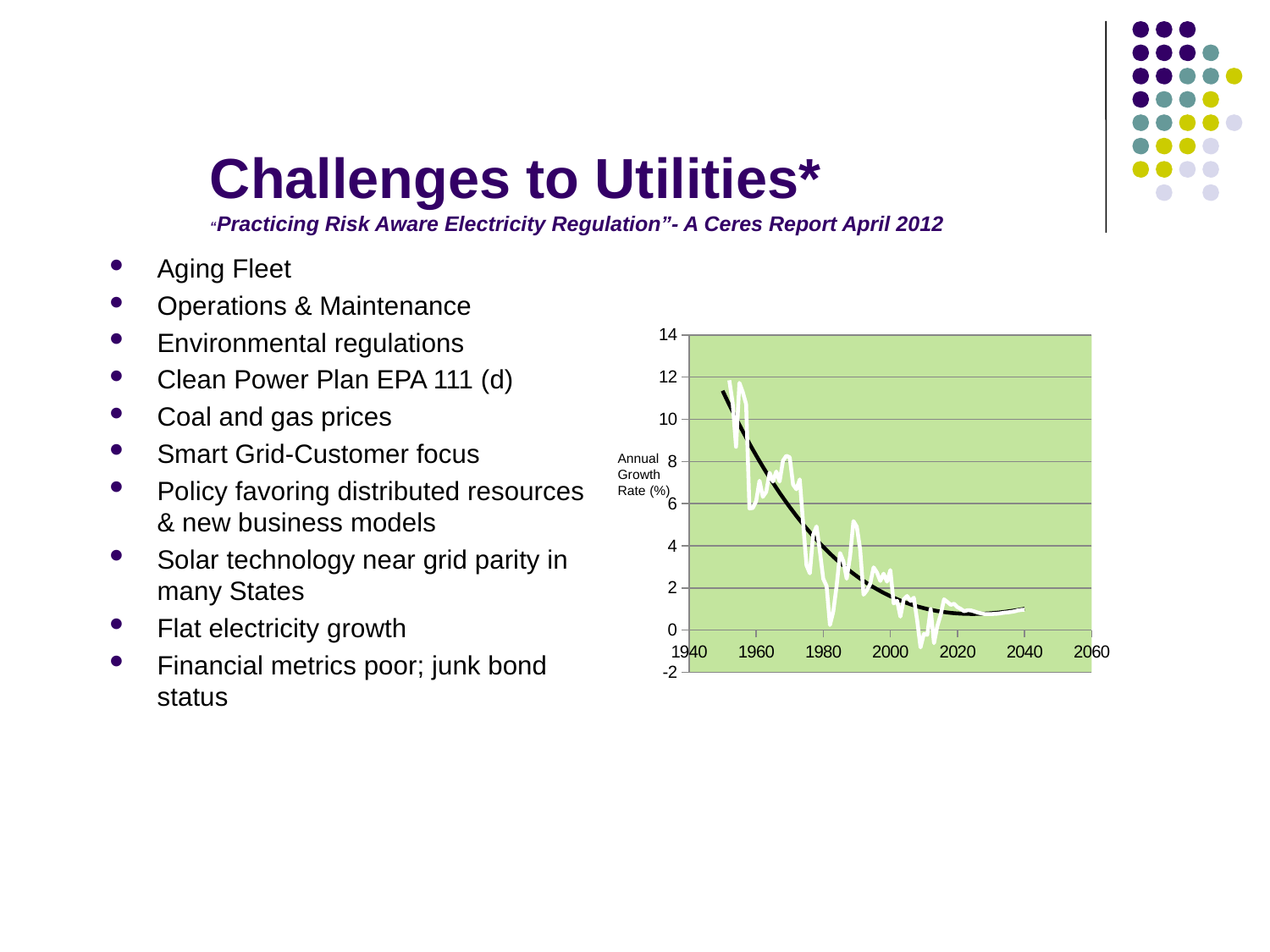
Is the value of the white line around 2020 greater or less than 4? less How many lines are plotted on the chart? 2 Is the value of the white line around 1955 greater or less than 8? greater Is the value of the black trend line around 1960 greater or less than 6? greater What is the lowest value shown on the vertical axis of the chart? -2 What kind of chart is shown on the slide? line chart Do the values on the chart generally rise or fall from 1940 to 2040? fall What is the highest value shown on the vertical axis of the chart? 14 What is the label on the vertical axis of the chart? Annual Growth Rate (%)